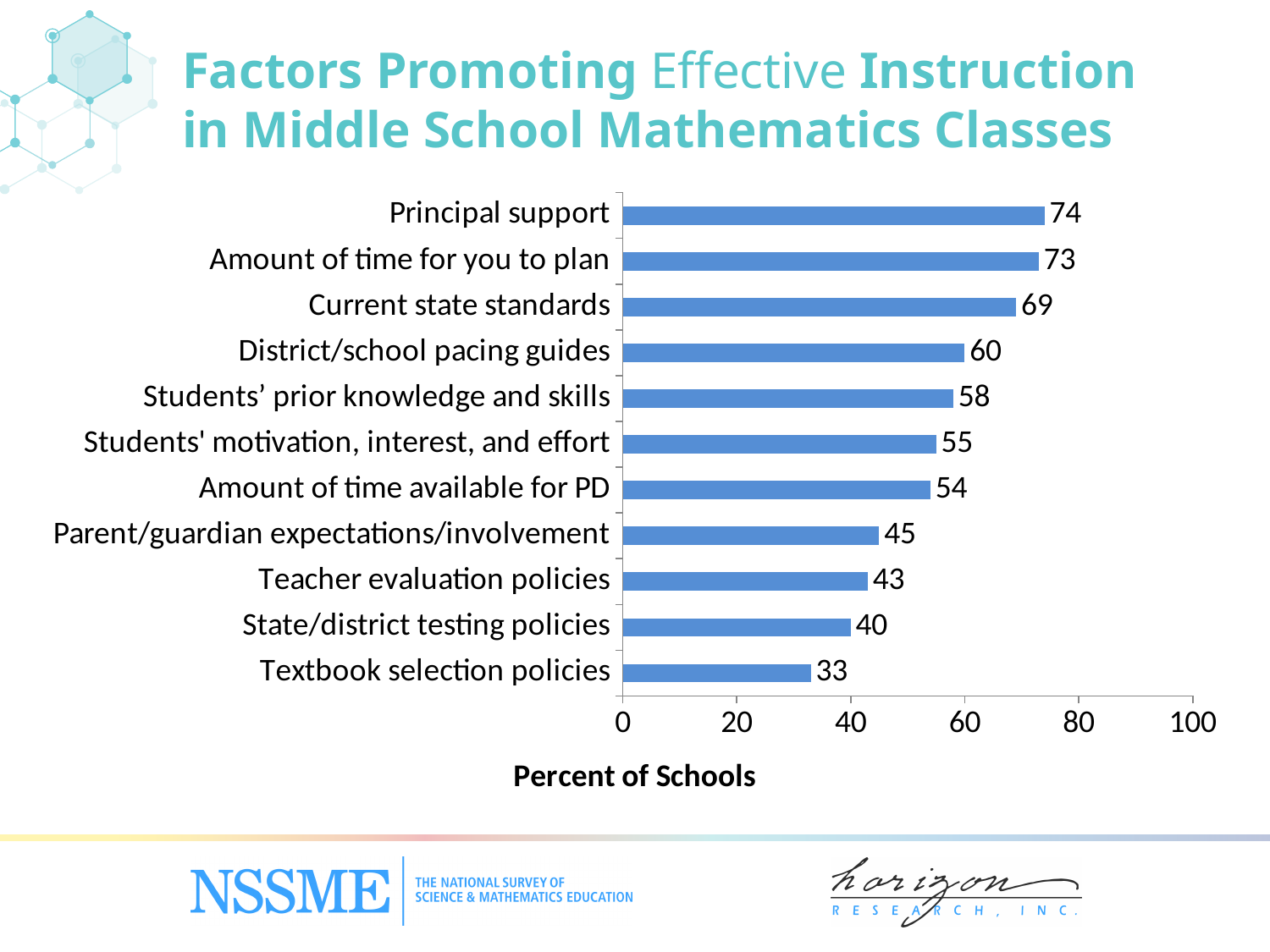
What is the difference between the values for Current state standards and District/school pacing guides? 9 Is the value for Parent/guardian expectations/involvement greater or less than 40? greater What kind of chart is shown on the slide? bar chart How many factors are plotted in the chart? 11 Which factor has the lowest percent of schools? Textbook selection policies What is the difference between the values for Principal support and Textbook selection policies? 41 What is the value for Textbook selection policies? 33 Which factor has the highest percent of schools? Principal support What is the label of the horizontal axis? Percent of Schools What is the value for Amount of time available for PD? 54 Which is larger: the value for Teacher evaluation policies or the value for State/district testing policies? Teacher evaluation policies What percent of schools is shown for Principal support? 74